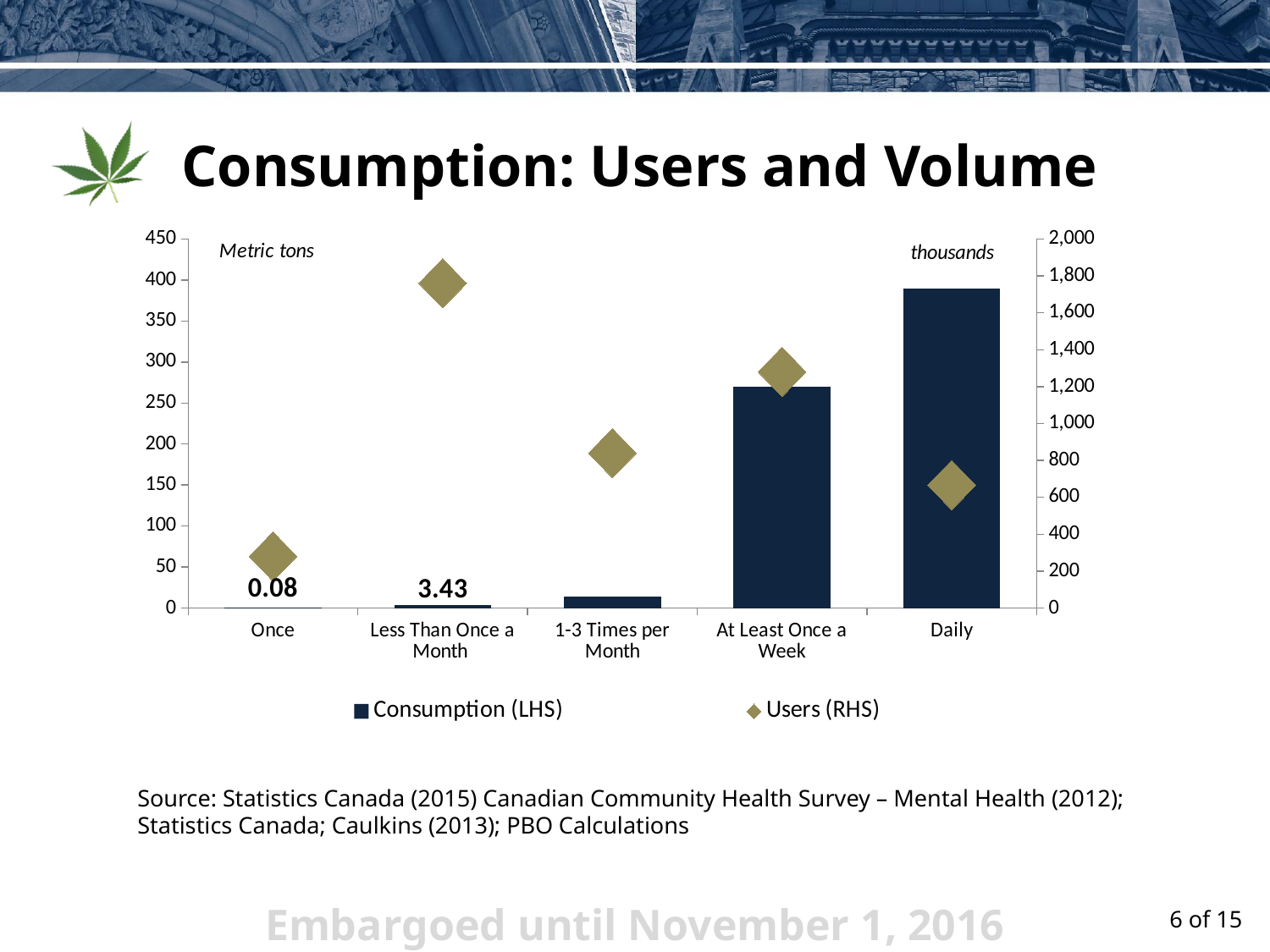
How many categories are shown on the x axis? 5 How many series does the legend list? 2 Which category has the highest Users (RHS) marker? Less Than Once a Month What is the Consumption (LHS) value for "Less Than Once a Month"? 3.43 Which category has the highest Consumption (LHS) bar? Daily Which category has the lowest Consumption (LHS) bar? Once Is the Users (RHS) value for "Daily" greater or less than 800? less What is the Consumption (LHS) value for the "Once" category? 0.08 Which category has the lowest Users (RHS) marker? Once Is the Consumption (LHS) value for "Daily" greater or less than 350? greater Which has the larger Consumption (LHS) value: "At Least Once a Week" or "Daily"? Daily What is the difference between the Consumption values for "Less Than Once a Month" and "Once"? 3.35